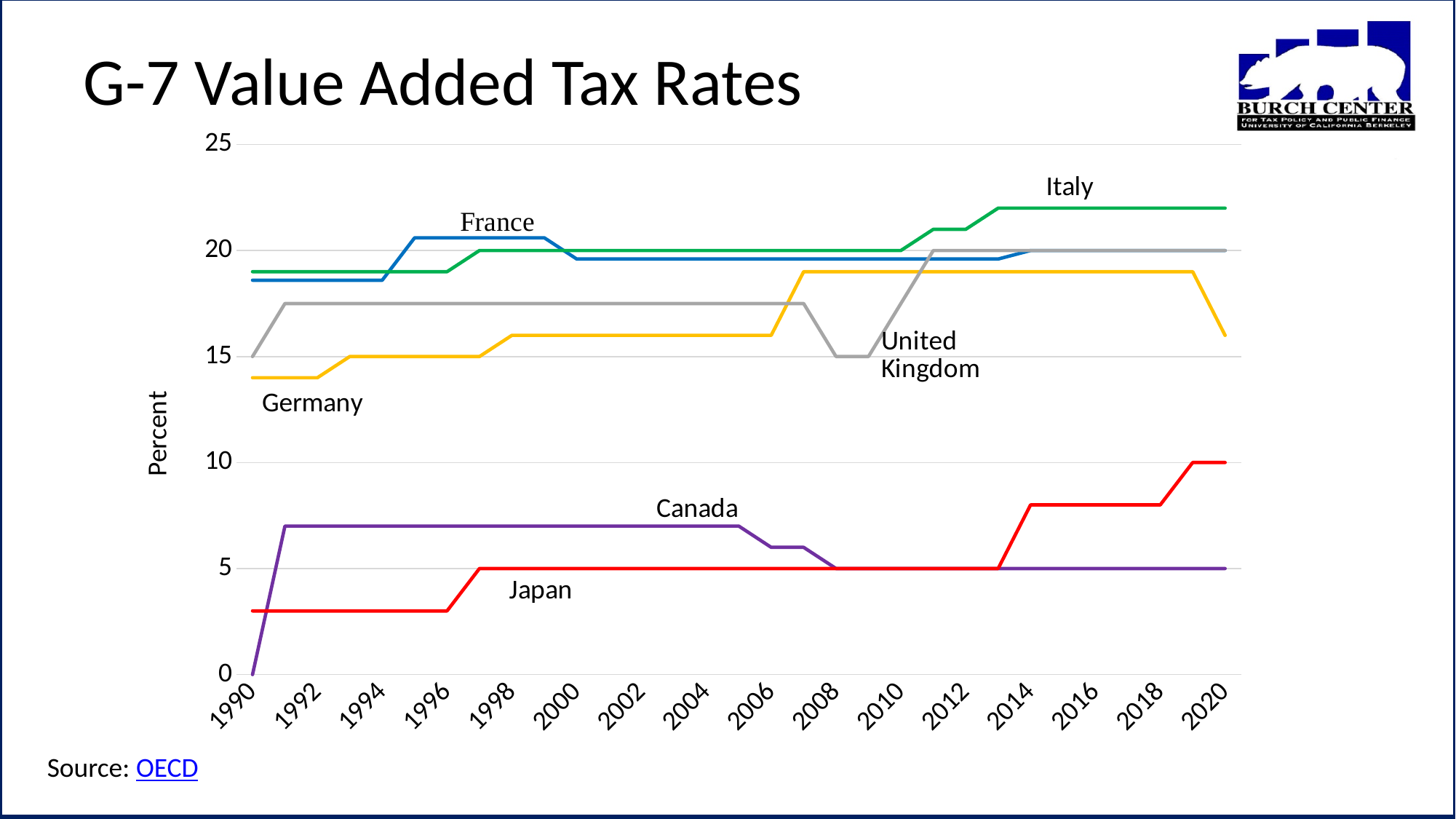
What kind of chart is shown on the slide? line chart What is the label on the vertical axis? Percent Which country has the highest value added tax rate in 2020? Italy Which country has the lowest value added tax rate in 2020? Canada In 2020, which has the higher value added tax rate, Japan or Canada? Japan What is Canada's value added tax rate in 2020? 5 What is the difference between Japan's and Canada's value added tax rates in 2020? 5 What is Italy's value added tax rate in 2005? 20 How many countries are plotted as lines on the chart? 6 Is Italy's value added tax rate in 2020 greater or less than 20? greater Is Germany's value added tax rate in 2020 greater or less than 20? less What is Japan's value added tax rate in 2020? 10